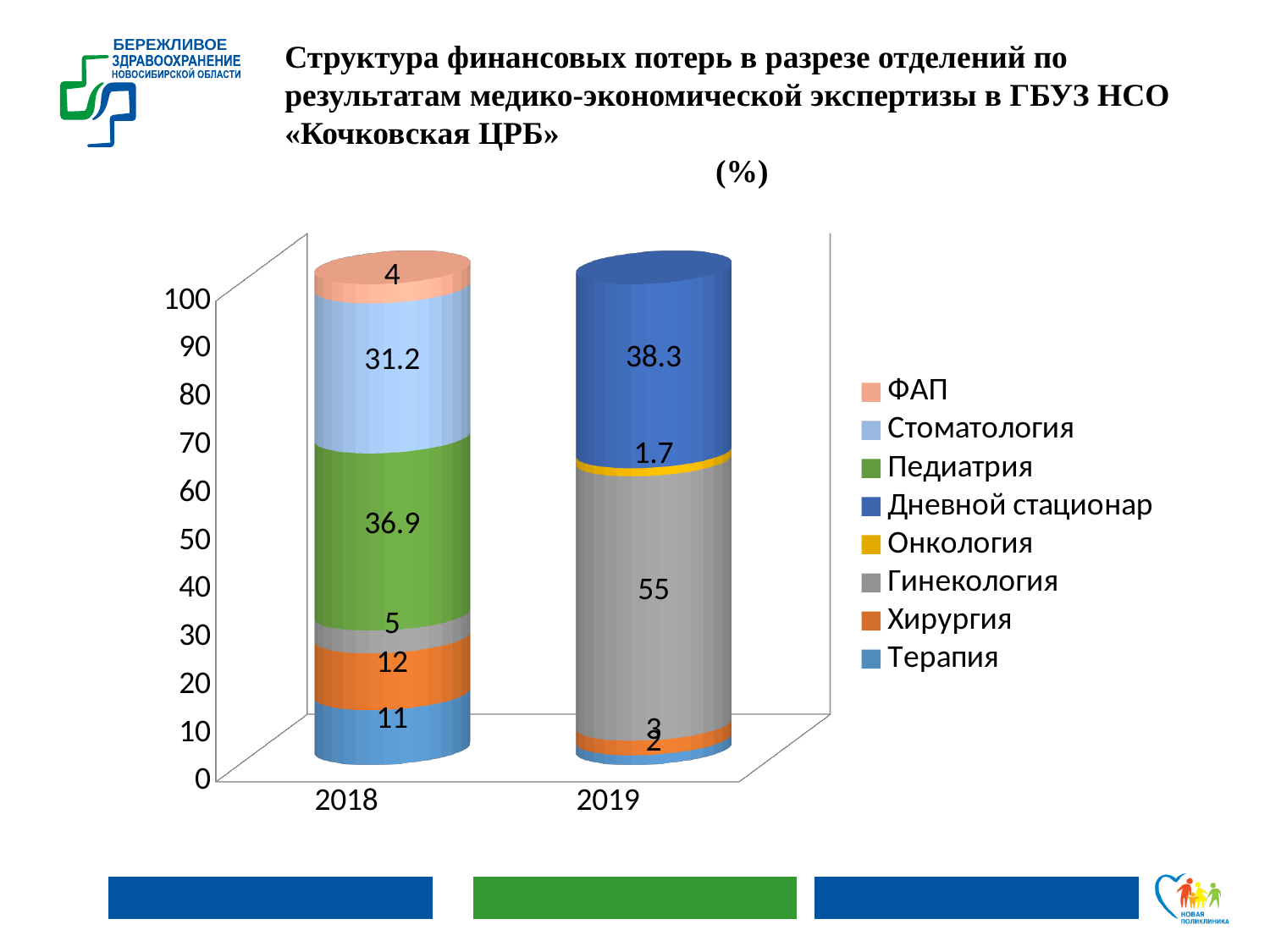
What is the value for Дневной стационар in 2019? 38.3 What is the value for Онкология in 2019? 1.7 What is the value for Педиатрия in 2018? 36.9 What is the value for Гинекология in 2019? 55 Which series has the largest value in the 2018 bar? Педиатрия What is the difference between the Гинекология value in 2019 and in 2018? 50 What is the total of the 2019 stacked bar? 100 How many years (categories) are shown on the x axis? 2 Which series has the smallest value in the 2019 bar? Онкология Which is larger: Стоматология in 2018 or Дневной стационар in 2019? Дневной стационар in 2019 What kind of chart is shown on the slide? Stacked bar chart How many series does the legend list? 8